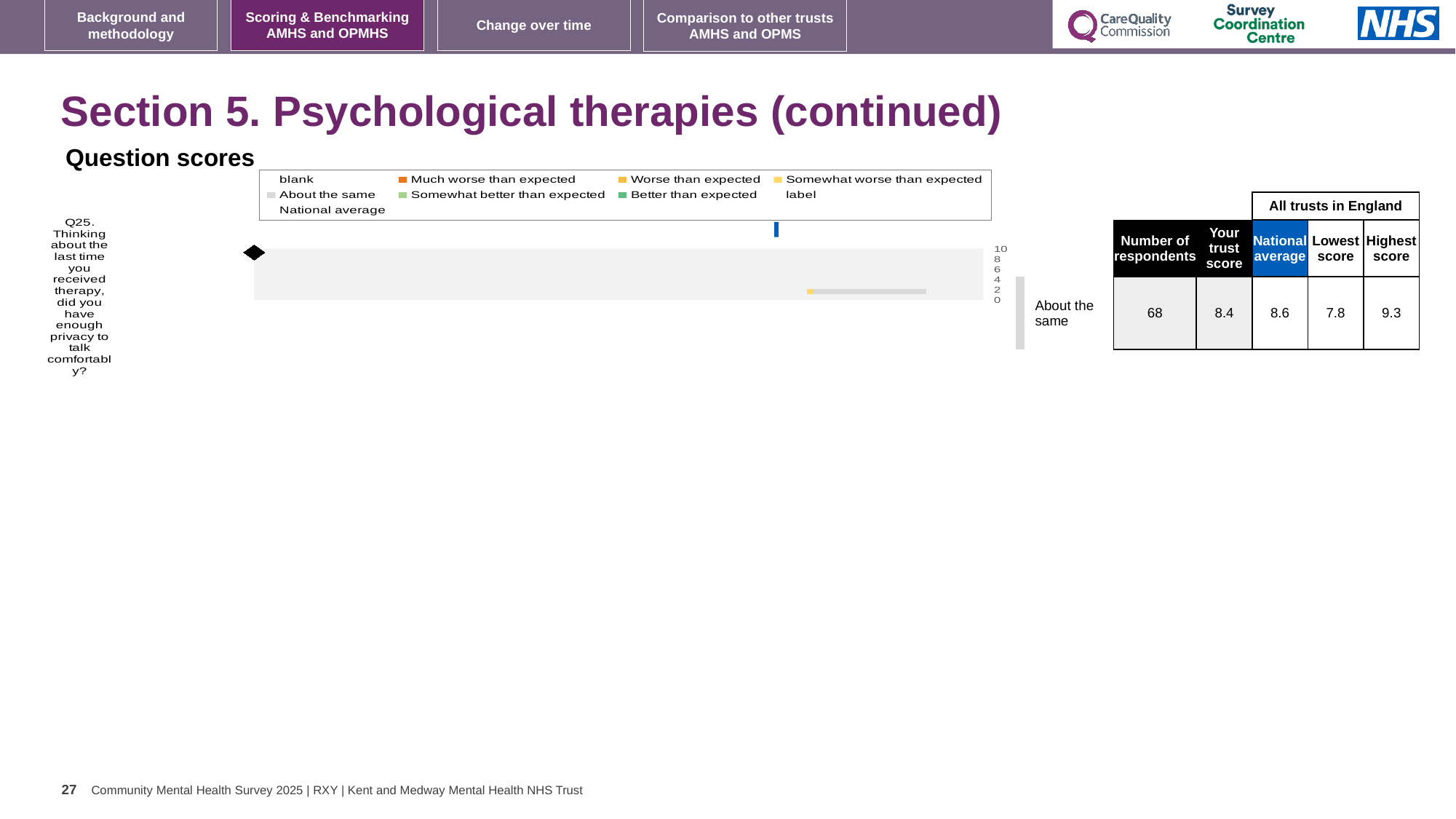
Which question number is plotted in the Question scores chart? Q25 What is the national average score for Q25? 8.6 What is the difference between the highest and lowest trust scores for Q25? 1.5 How is the trust's Q25 score categorised relative to expectation? About the same What is the highest tick value shown on the score axis of the Question scores chart? 10 How many respondents answered Q25? 68 What is the lowest score among all trusts in England for Q25? 7.8 What is the highest score among all trusts in England for Q25? 9.3 What kind of chart is shown under 'Question scores'? bar chart Which is larger for Q25: the trust's score or the national average? national average How many survey questions are plotted in the Question scores chart? 1 What is the trust's score for Q25 (privacy to talk comfortably during therapy)? 8.4